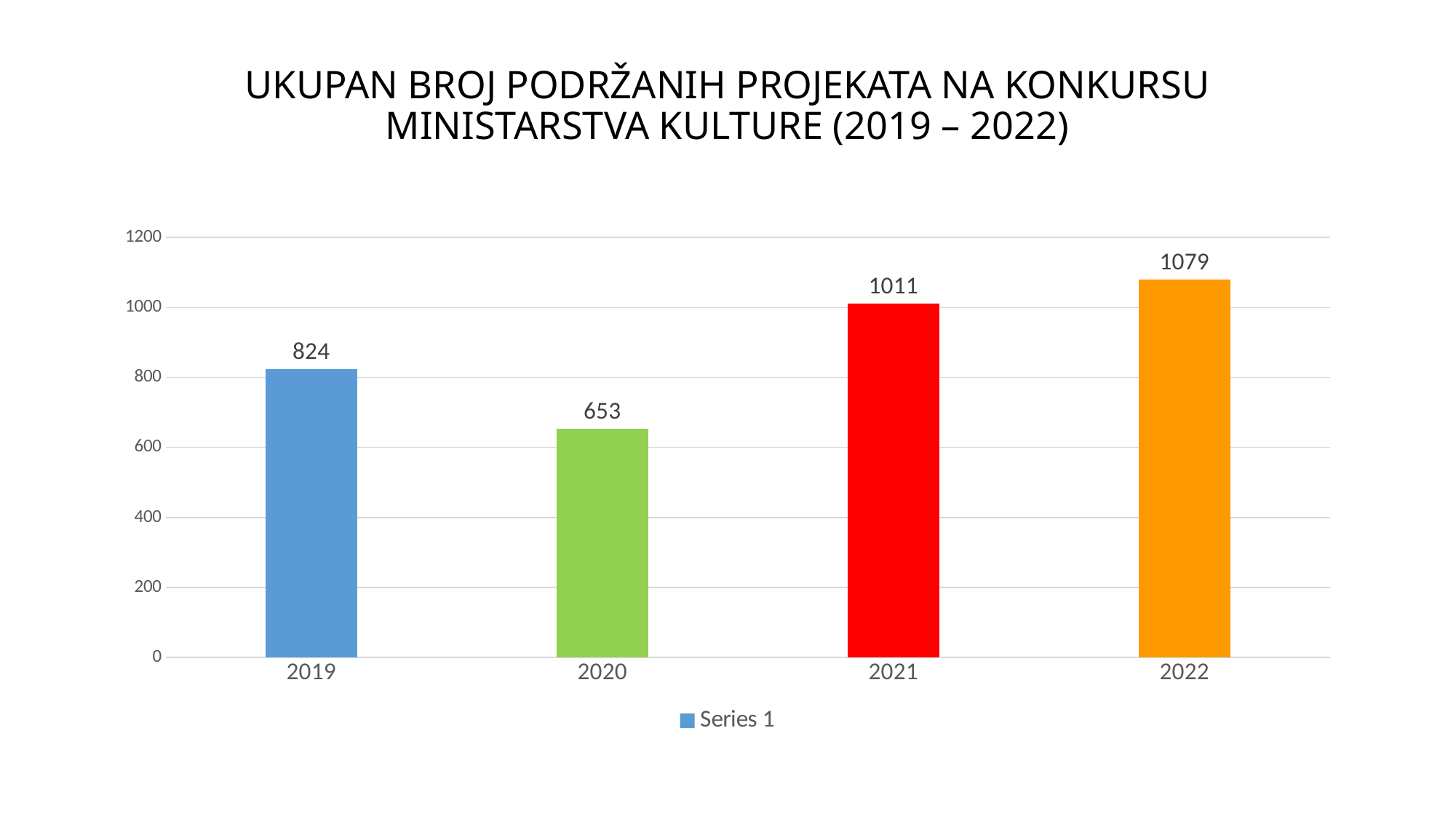
What is the value for 2022? 1079 Which is larger, the value for 2019 or the value for 2021? 2021 What is the value for 2019? 824 What is the difference between the values for 2022 and 2021? 68 Which year has the highest value? 2022 What is the name of the series listed in the legend? Series 1 What is the value for 2020? 653 What is the difference between the values for 2019 and 2020? 171 Which year has the lowest value? 2020 What kind of chart is shown on the slide? bar chart How many years are shown on the x axis? 4 What is the value for 2021? 1011